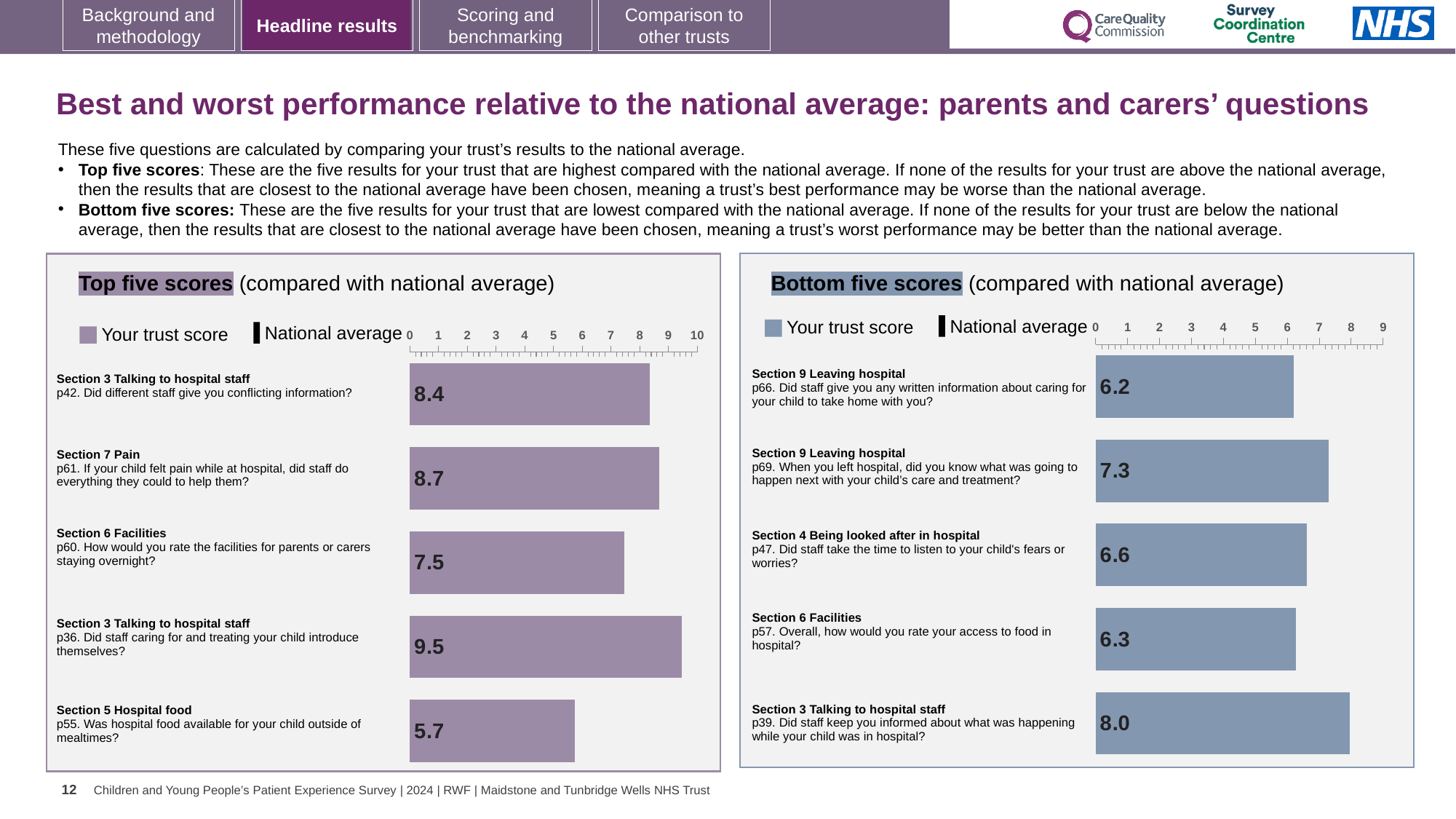
In the Bottom five scores chart, which question has the highest trust score? p39. Did staff keep you informed about what was happening while your child was in hospital? In the Bottom five scores chart, which has the larger trust score: p47 (listen to your child's fears or worries) or p57 (access to food in hospital)? p47 In the Top five scores chart, what is the difference between the trust scores for p61 (Pain) and p60 (Facilities)? 1.2 What two entries does the legend of the Top five scores chart list? Your trust score; National average In the Bottom five scores chart, which question has the lowest trust score? p66. Did staff give you any written information about caring for your child to take home with you? How many bars are plotted in the Top five scores chart? 5 In the Top five scores chart, which question has the lowest trust score? p55. Was hospital food available for your child outside of mealtimes? In the Top five scores chart, what is the trust score for p36 (Did staff caring for and treating your child introduce themselves?)? 9.5 In the Bottom five scores chart, what is the trust score for p69 (When you left hospital, did you know what was going to happen next with your child's care and treatment?)? 7.3 In the Top five scores chart, which question has the highest trust score? p36. Did staff caring for and treating your child introduce themselves? What type of chart is the Bottom five scores chart? Bar chart In the Bottom five scores chart, what is the difference between the trust scores for p39 and p66? 1.8